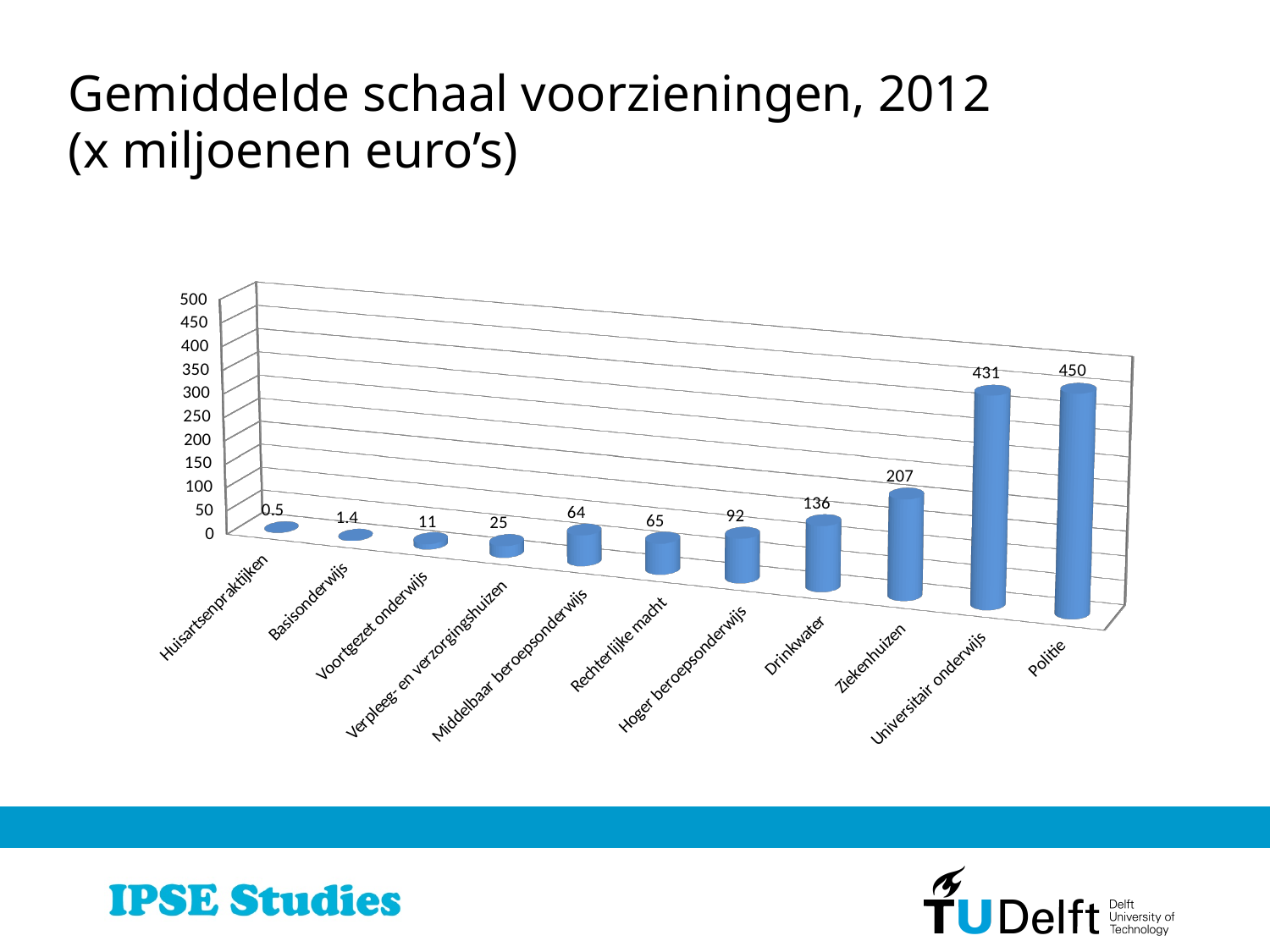
Which category has the lowest value? Huisartsenpraktijken How many categories are shown in the chart? 11 What is the value for Politie? 450 What is the value for Ziekenhuizen? 207 What is the value for Drinkwater? 136 Which is larger, the value for Drinkwater or the value for Hoger beroepsonderwijs? Drinkwater Do the values rise or fall from left to right along the x axis? Rise What is the difference between the values for Politie and Universitair onderwijs? 19 What is the value for Huisartsenpraktijken? 0.5 Which category has the highest value? Politie What kind of chart is shown on the slide? Bar chart What is the difference between the values for Ziekenhuizen and Drinkwater? 71